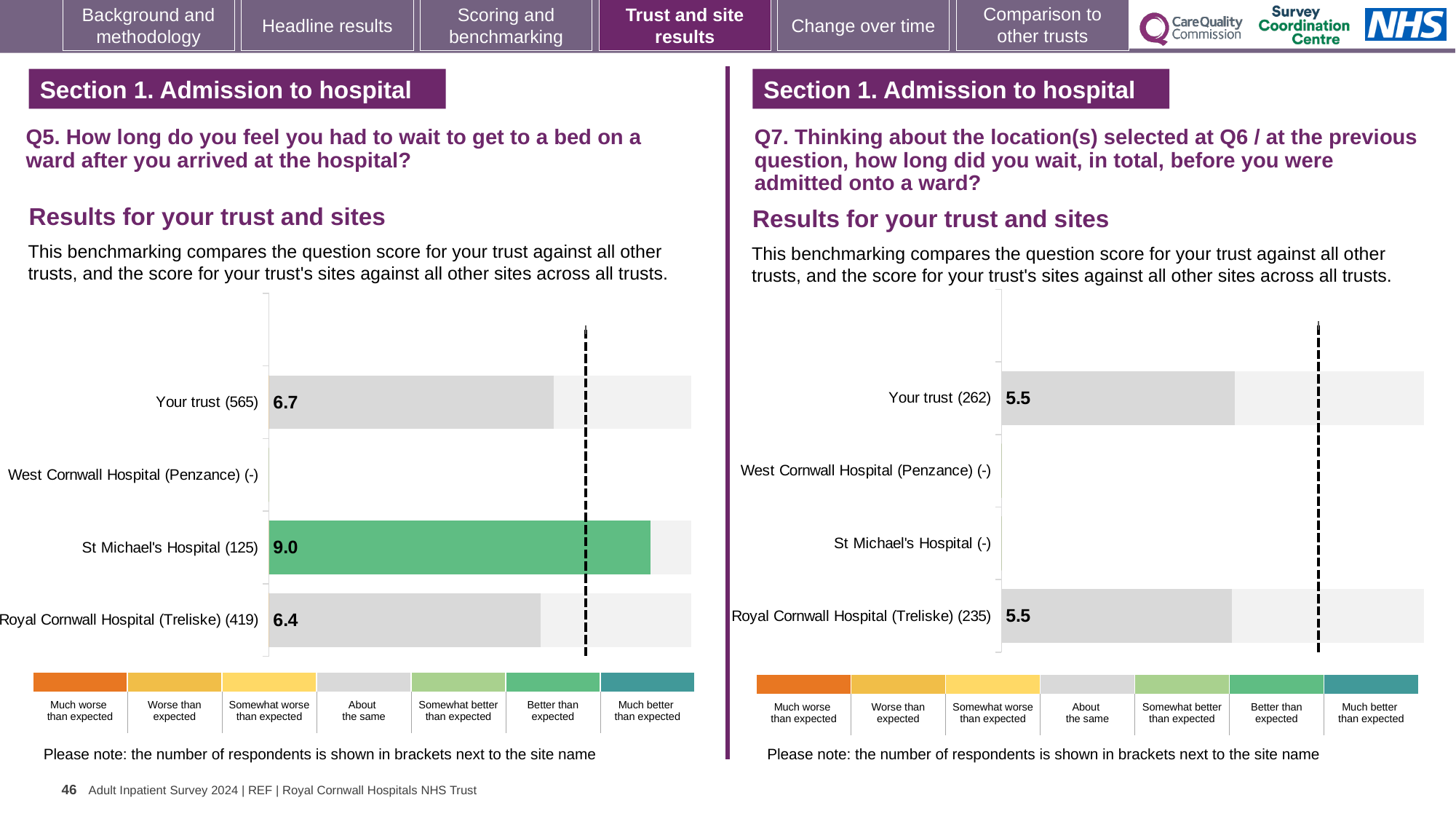
In the Q5 chart on the left, which labelled bar has the lowest score? Royal Cornwall Hospital (Treliske) (419) In the Q5 chart on the left, what is the score for St Michael's Hospital (125)? 9.0 In the Q5 chart on the left, what is the score for Royal Cornwall Hospital (Treliske) (419)? 6.4 In the Q5 chart on the left, which bar is coloured green? St Michael's Hospital (125) In the Q5 chart on the left, what is the difference between the scores for St Michael's Hospital and Royal Cornwall Hospital (Treliske)? 2.6 In the Q5 chart on the left, which site has the highest score? St Michael's Hospital (125) In the Q7 chart on the right, what is the score for Your trust (262)? 5.5 In the Q5 chart on the left, what is the score for Your trust (565)? 6.7 How many categories are listed on the vertical axis of the Q7 chart on the right? 4 In the Q7 chart on the right, what is the score for Royal Cornwall Hospital (Treliske) (235)? 5.5 What kind of chart is the Q5 chart on the left? Bar chart In the Q5 chart on the left, which is larger: the score for Your trust or the score for Royal Cornwall Hospital (Treliske)? Your trust